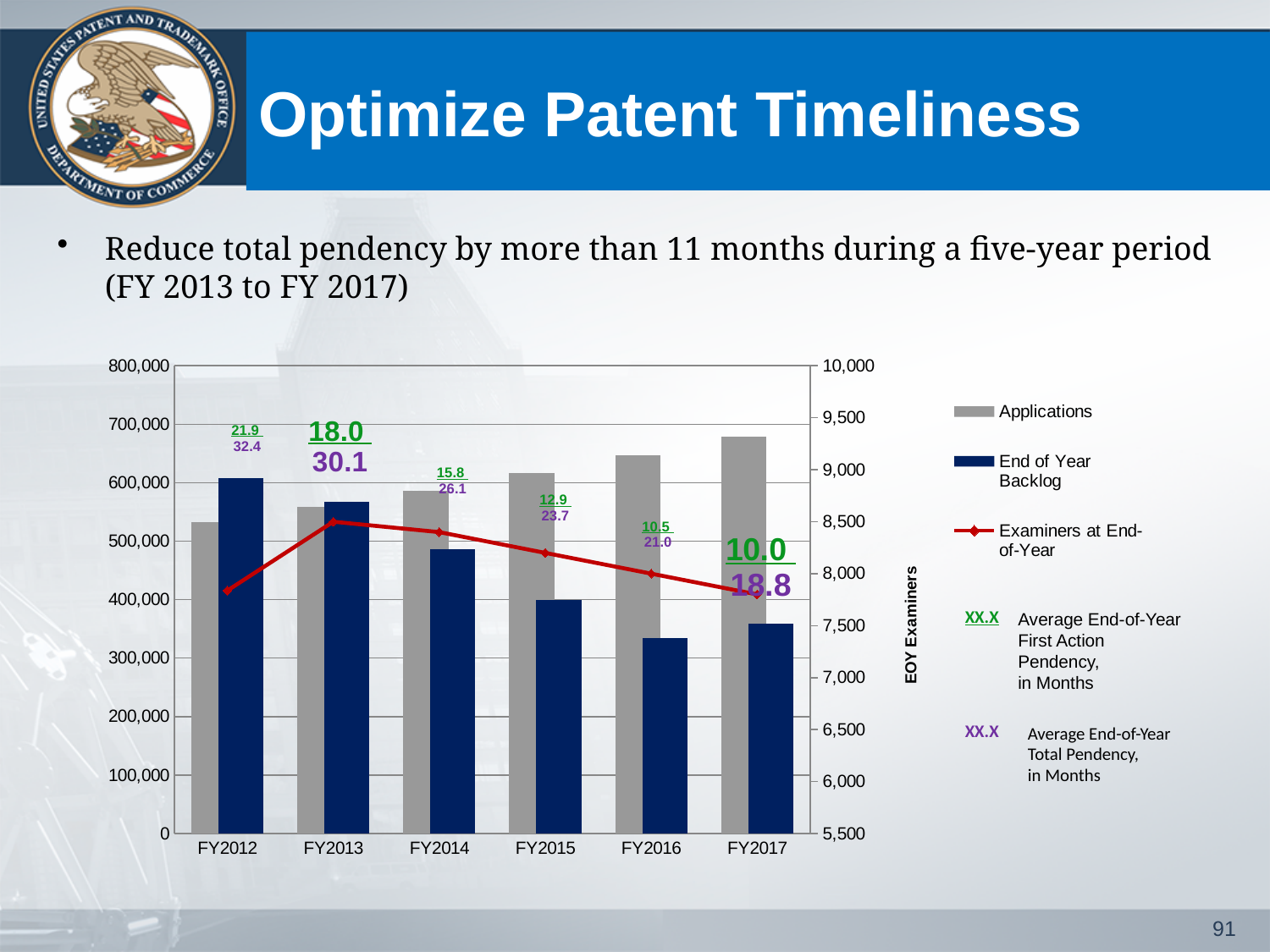
Is the End of Year Backlog value for FY2016 greater or less than 400,000? less What is the Average End-of-Year Total Pendency, in months, shown for FY2017? 18.8 By how many months does the Average End-of-Year Total Pendency fall from FY2012 (32.4) to FY2017 (18.8)? 13.6 In which fiscal year is the End of Year Backlog bar the shortest? FY2016 In FY2017, which is larger: Applications or End of Year Backlog? Applications What is the Average End-of-Year Total Pendency, in months, shown for FY2012? 32.4 What is the label on the right-hand vertical axis of the chart? EOY Examiners How many fiscal years are shown on the x axis of the chart? 6 Is the Applications value for FY2012 greater or less than 500,000? greater In which fiscal year is the Applications bar the tallest? FY2017 Do the Average End-of-Year First Action Pendency values rise or fall from FY2012 to FY2017? fall What is the Average End-of-Year First Action Pendency, in months, shown for FY2014? 15.8